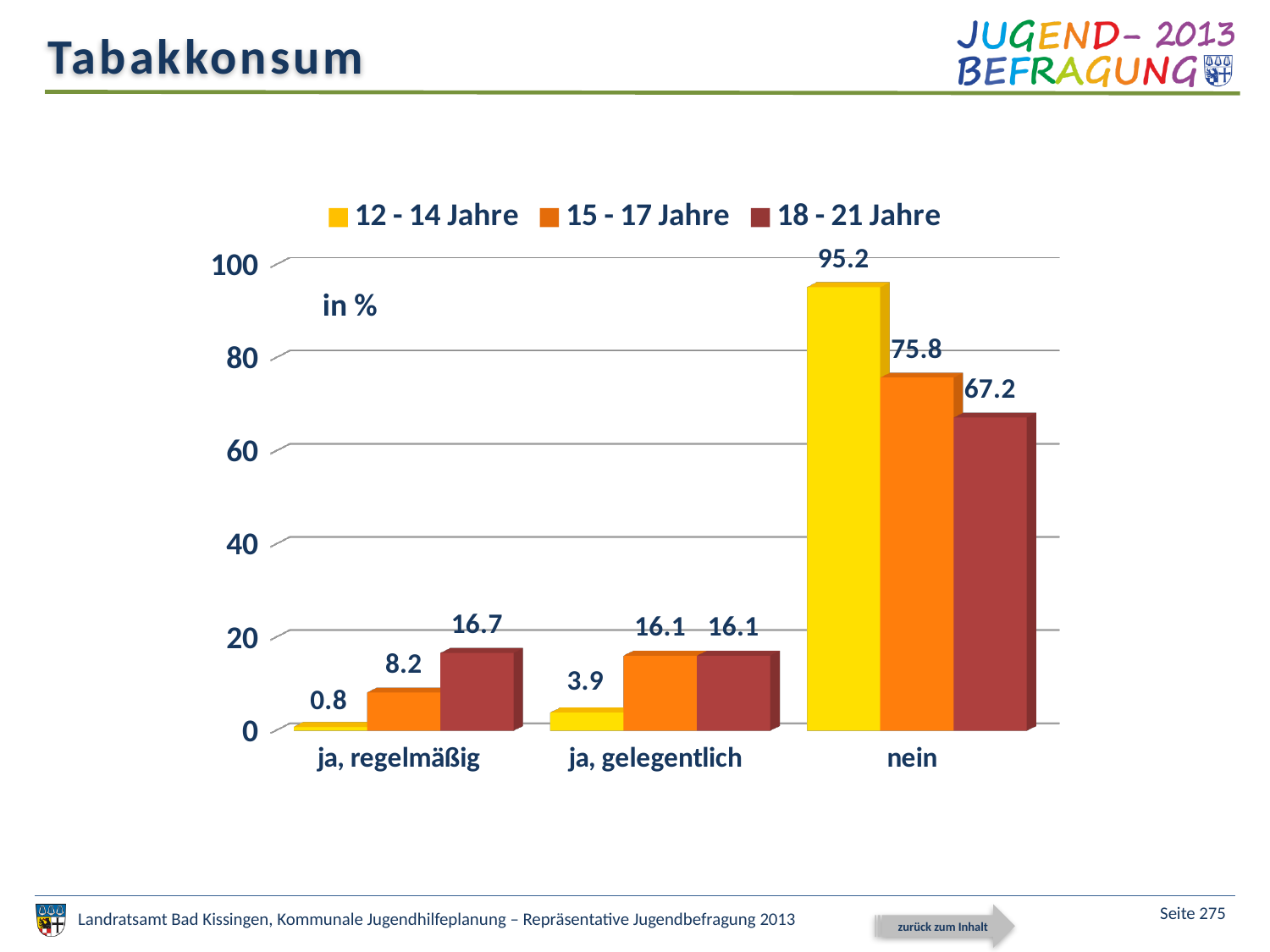
Which age group has the lowest value in the "ja, gelegentlich" category? 12 - 14 Jahre What is the value for the 18 - 21 Jahre series in the "ja, regelmäßig" category? 16.7 What is the value for the 12 - 14 Jahre series in the "nein" category? 95.2 What is the value for the 12 - 14 Jahre series in the "ja, regelmäßig" category? 0.8 Which is larger: the 15 - 17 Jahre value for "ja, regelmäßig" or the 12 - 14 Jahre value for "ja, gelegentlich"? 15 - 17 Jahre value for "ja, regelmäßig" Which age group has the highest value in the "nein" category? 12 - 14 Jahre How many series does the legend list? 3 What is the value for the 15 - 17 Jahre series in the "ja, gelegentlich" category? 16.1 What kind of chart is shown on the slide? bar chart How many categories are shown on the x axis? 3 What is the difference between the 12 - 14 Jahre and 18 - 21 Jahre values in the "nein" category? 28 What unit is indicated on the chart? in %